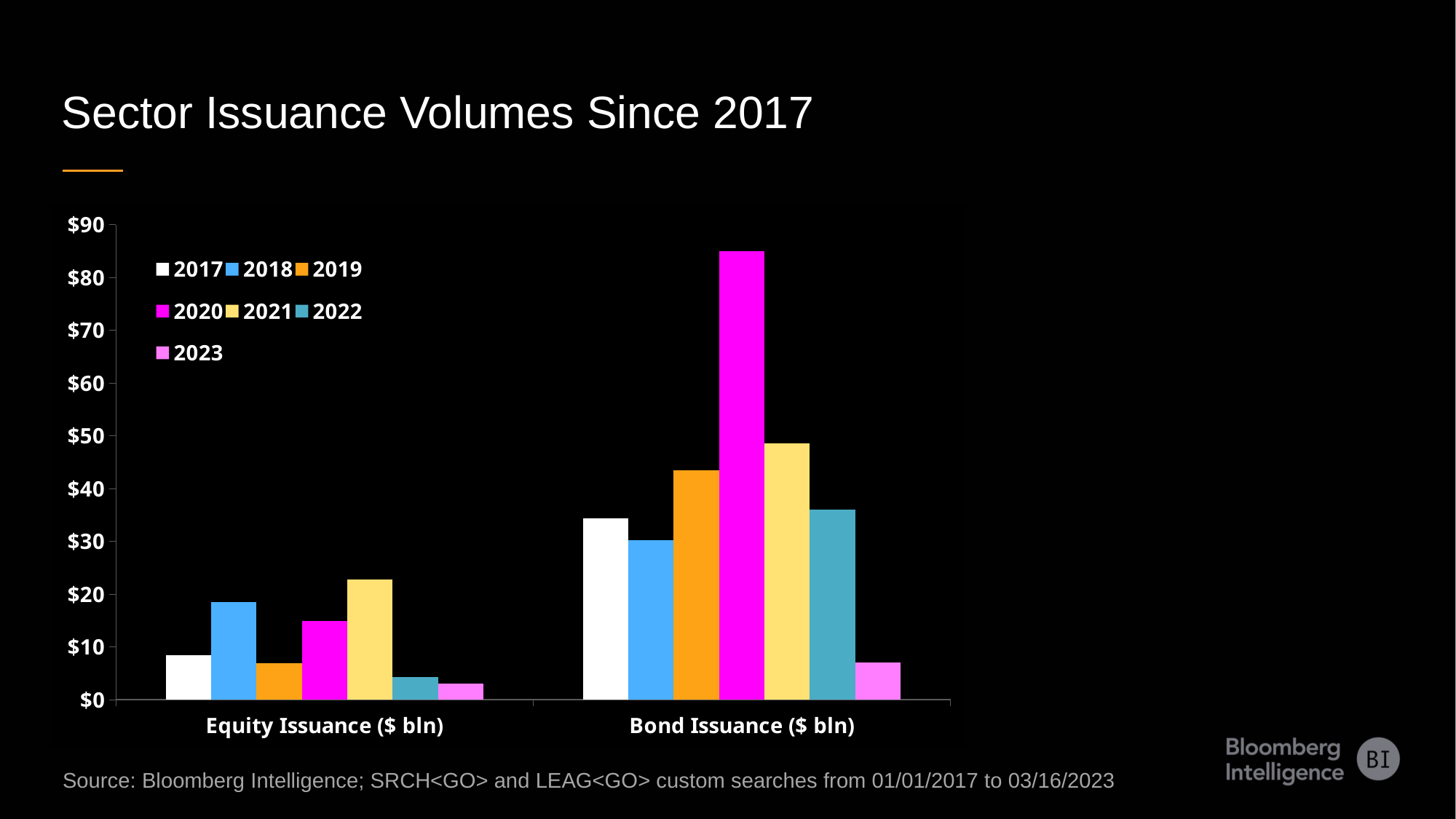
What is the title of the slide? Sector Issuance Volumes Since 2017 Which year has the highest Equity Issuance ($ bln)? 2021 Which year has the lowest Bond Issuance ($ bln)? 2023 Which year has the highest Bond Issuance ($ bln)? 2020 Is the Bond Issuance ($ bln) value for 2020 greater or less than $80? greater Which is larger: Equity Issuance ($ bln) for 2018 or for 2020? 2018 What kind of chart is shown on the slide? Bar chart Is the Equity Issuance ($ bln) value for 2021 greater or less than $20? greater Which is larger: Bond Issuance ($ bln) for 2019 or for 2018? 2019 How many series does the legend list? 7 How many categories are shown on the x axis? 2 Is the Bond Issuance ($ bln) value for 2021 greater or less than $40? greater